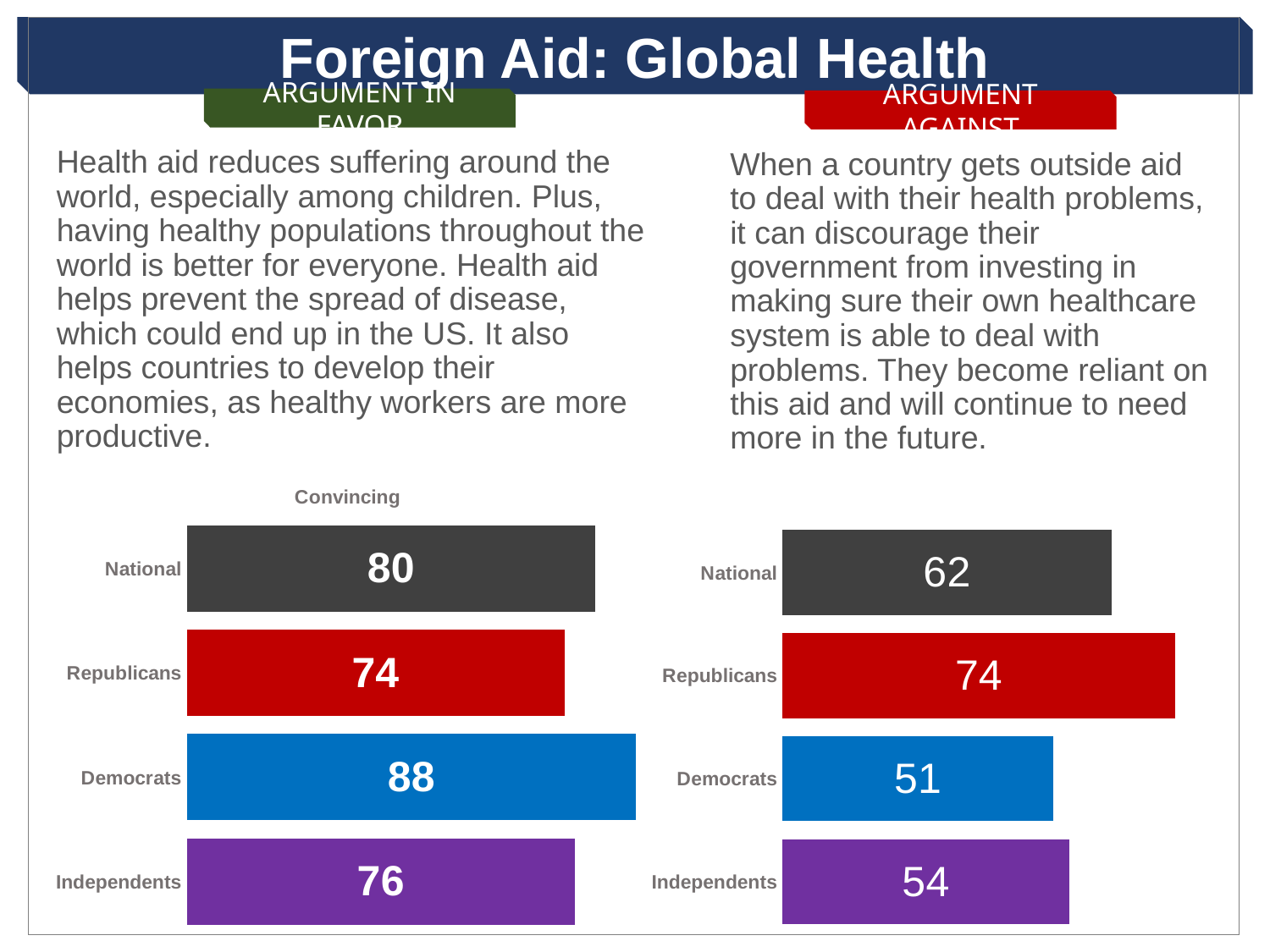
How many categories are shown in the left chart (under Argument in Favor)? 4 In the right chart (under Argument Against), which category has the lowest value? Democrats In the left chart (under Argument in Favor), what is the difference between the values for Democrats and Republicans? 14 In the left chart (under Argument in Favor), which category has the highest value? Democrats What type of chart is the right chart (under Argument Against)? Bar chart In the left chart (under Argument in Favor), which category has the lowest value? Republicans In the right chart (under Argument Against), which is larger, the value for Independents or the value for Democrats? Independents In the right chart (under Argument Against), what is the value for Independents? 54 In the left chart (under Argument in Favor), what is the value for Democrats? 88 In the right chart (under Argument Against), what is the value for National? 62 In the right chart (under Argument Against), which category has the highest value? Republicans In the right chart (under Argument Against), what is the difference between the values for National and Democrats? 11